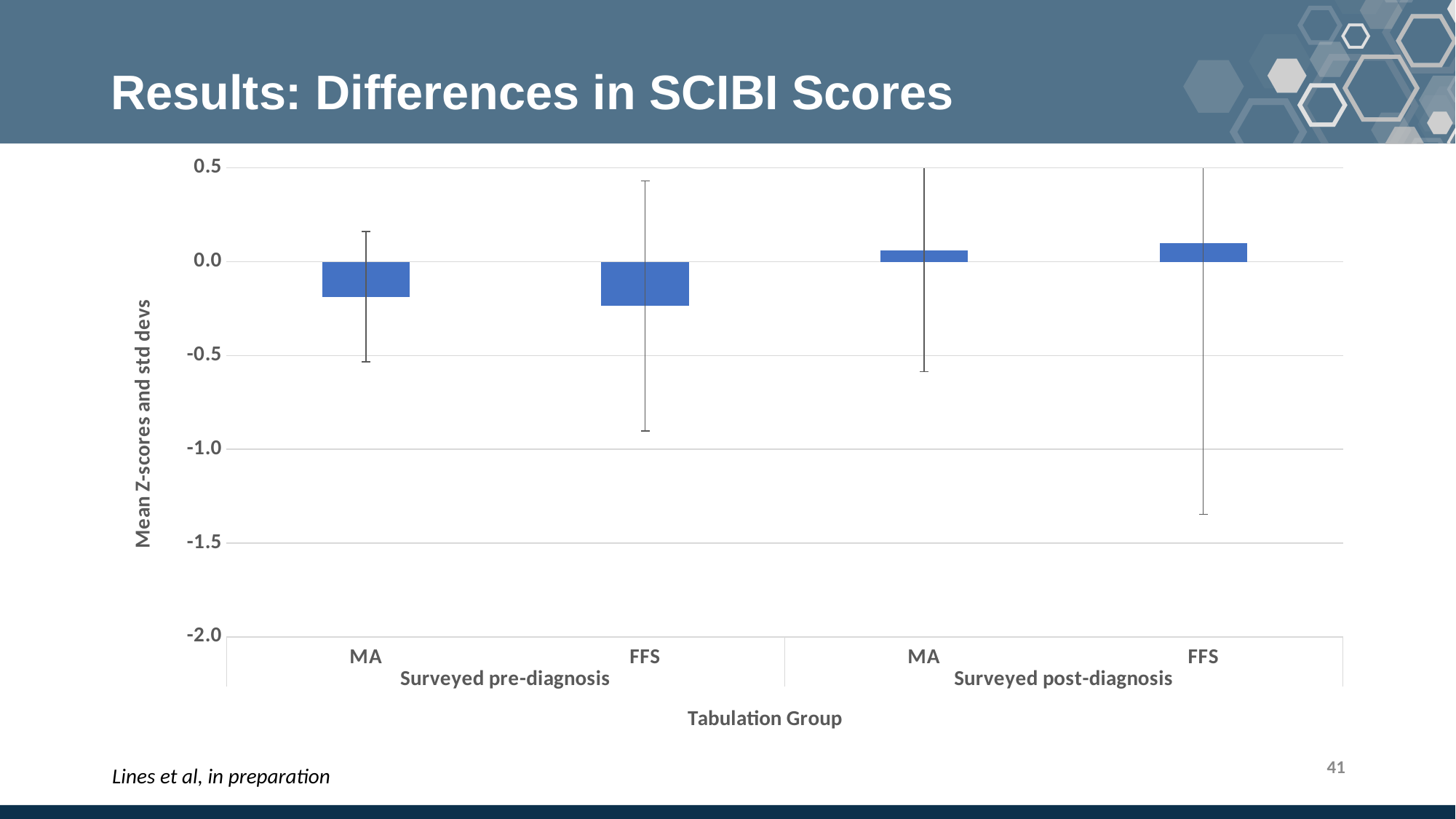
Is the value for FFS in the Surveyed pre-diagnosis group greater or less than -0.5? greater How many bars are plotted in the chart? 4 Is the value for MA in the Surveyed pre-diagnosis group greater or less than 0.0? less What is the label of the horizontal axis? Tabulation Group Which is larger: the value for MA surveyed pre-diagnosis or MA surveyed post-diagnosis? MA surveyed post-diagnosis Which is larger: the value for FFS surveyed pre-diagnosis or FFS surveyed post-diagnosis? FFS surveyed post-diagnosis What kind of chart is shown on the slide? bar chart Which bar has the lowest value in the chart? FFS, Surveyed pre-diagnosis Is the value for FFS in the Surveyed post-diagnosis group greater or less than 0.0? greater What is the label of the vertical axis? Mean Z-scores and std devs